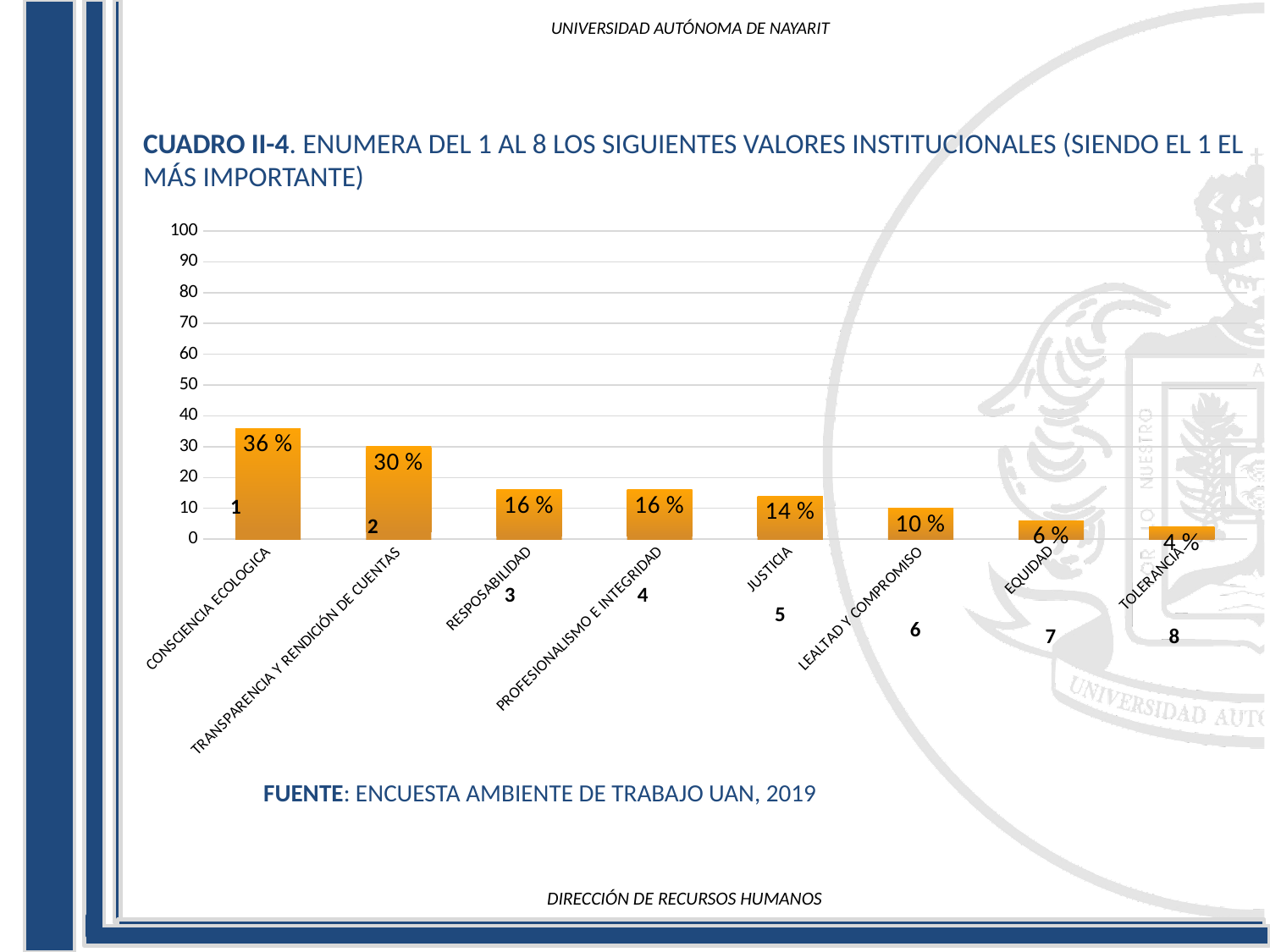
What kind of chart is shown on the slide? bar chart What is the value for TRANSPARENCIA Y RENDICIÓN DE CUENTAS? 30 % Do the values rise or fall from left to right along the x axis? fall What is the value for CONSCIENCIA ECOLOGICA? 36 % Which category has the highest value? CONSCIENCIA ECOLOGICA How many categories are shown on the x axis? 8 What is the value for TOLERANCIA? 4 % Is the value for CONSCIENCIA ECOLOGICA greater or less than 30? greater What is the value for JUSTICIA? 14 % Which is larger, the value for LEALTAD Y COMPROMISO or the value for EQUIDAD? LEALTAD Y COMPROMISO Which category has the lowest value? TOLERANCIA What is the difference between the values for CONSCIENCIA ECOLOGICA and TRANSPARENCIA Y RENDICIÓN DE CUENTAS? 6 %